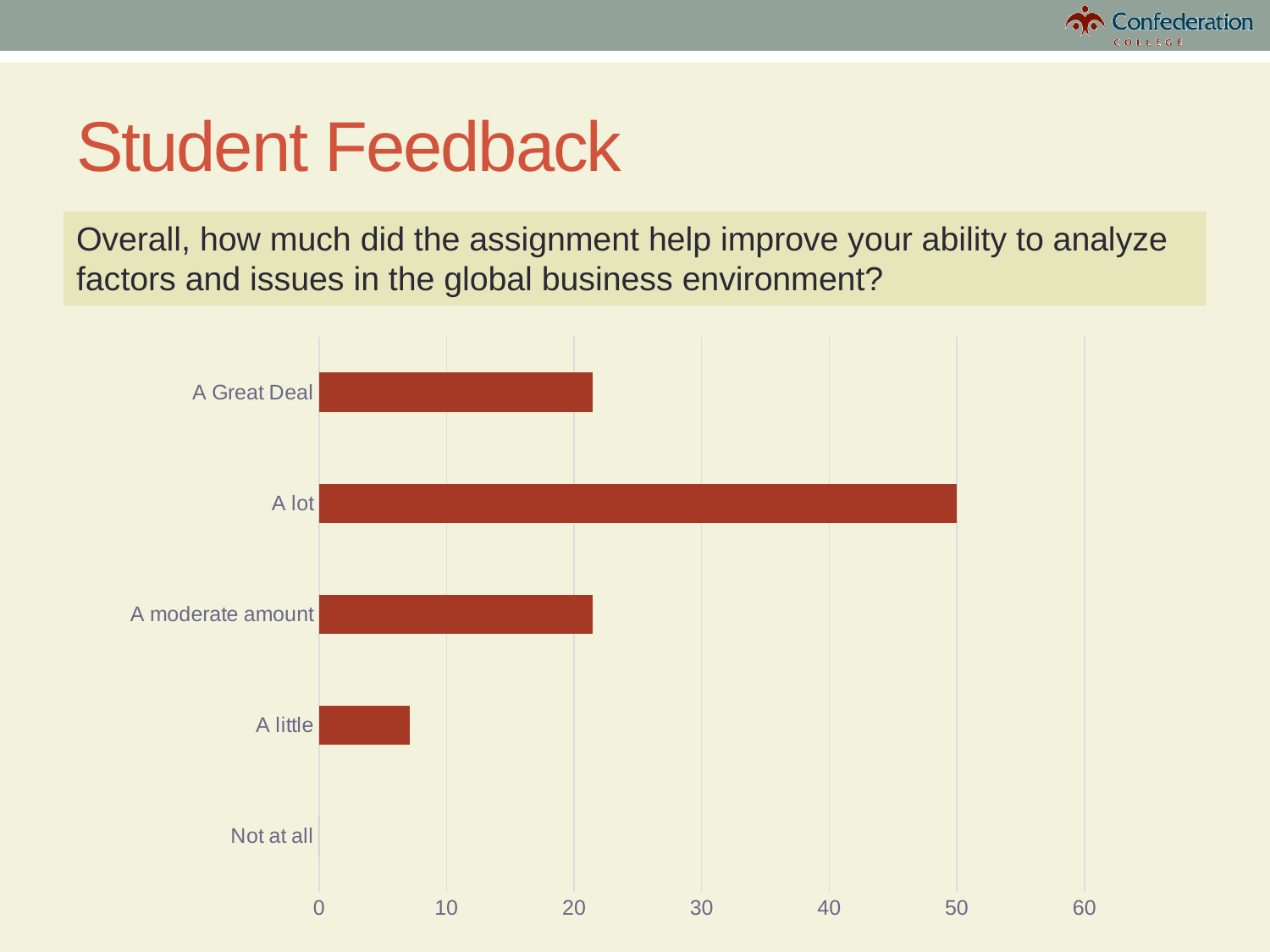
Which is larger, the value for "A Great Deal" or the value for "A little"? A Great Deal Is the value for "A moderate amount" greater or less than 30? less Is the value for "A Great Deal" greater or less than 20? greater Which response category has the highest value? A lot What is the value for "A lot"? 50 What is the value for "Not at all"? 0 What is the highest value labelled on the horizontal axis? 60 How many response categories are shown on the chart? 5 What kind of chart is shown on the slide? bar chart Which response category has the lowest value? Not at all Which is larger, the value for "A lot" or the value for "A little"? A lot Is the value for "A little" greater or less than 10? less